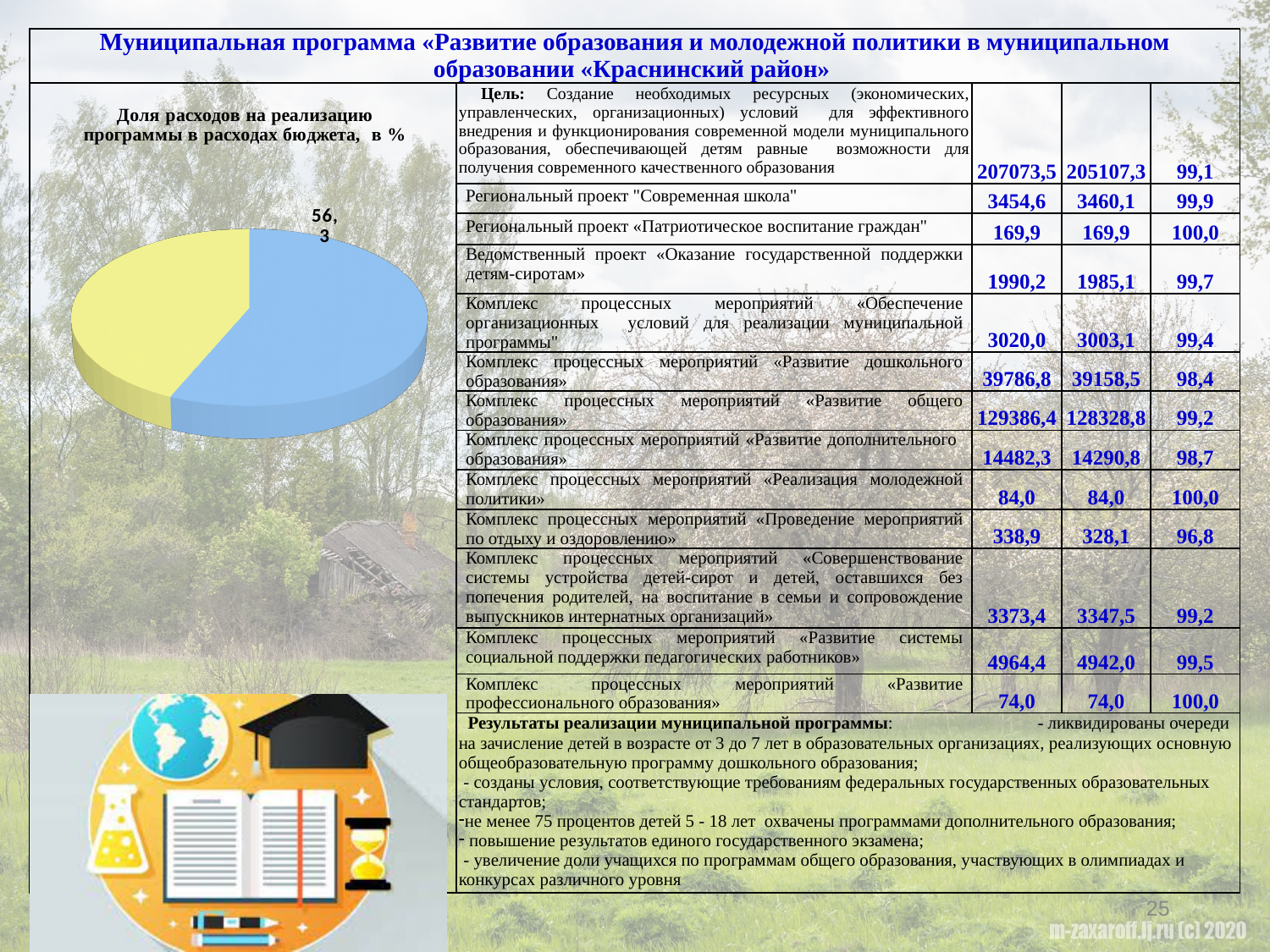
What is the title of the pie chart? Доля расходов на реализацию программы в расходах бюджета, в % Which slice of the pie chart is the largest? the blue slice What two colours are used for the slices of the pie chart? blue and yellow What value is printed as a data label on the pie chart? 56,3 Which slice of the pie chart is the smallest? the yellow slice What kind of chart is shown on the left of the slide under the heading «Доля расходов на реализацию программы в расходах бюджета, в %»? pie chart How many slices does the pie chart have? 2 Which slice of the pie chart is larger, the blue one or the yellow one? blue